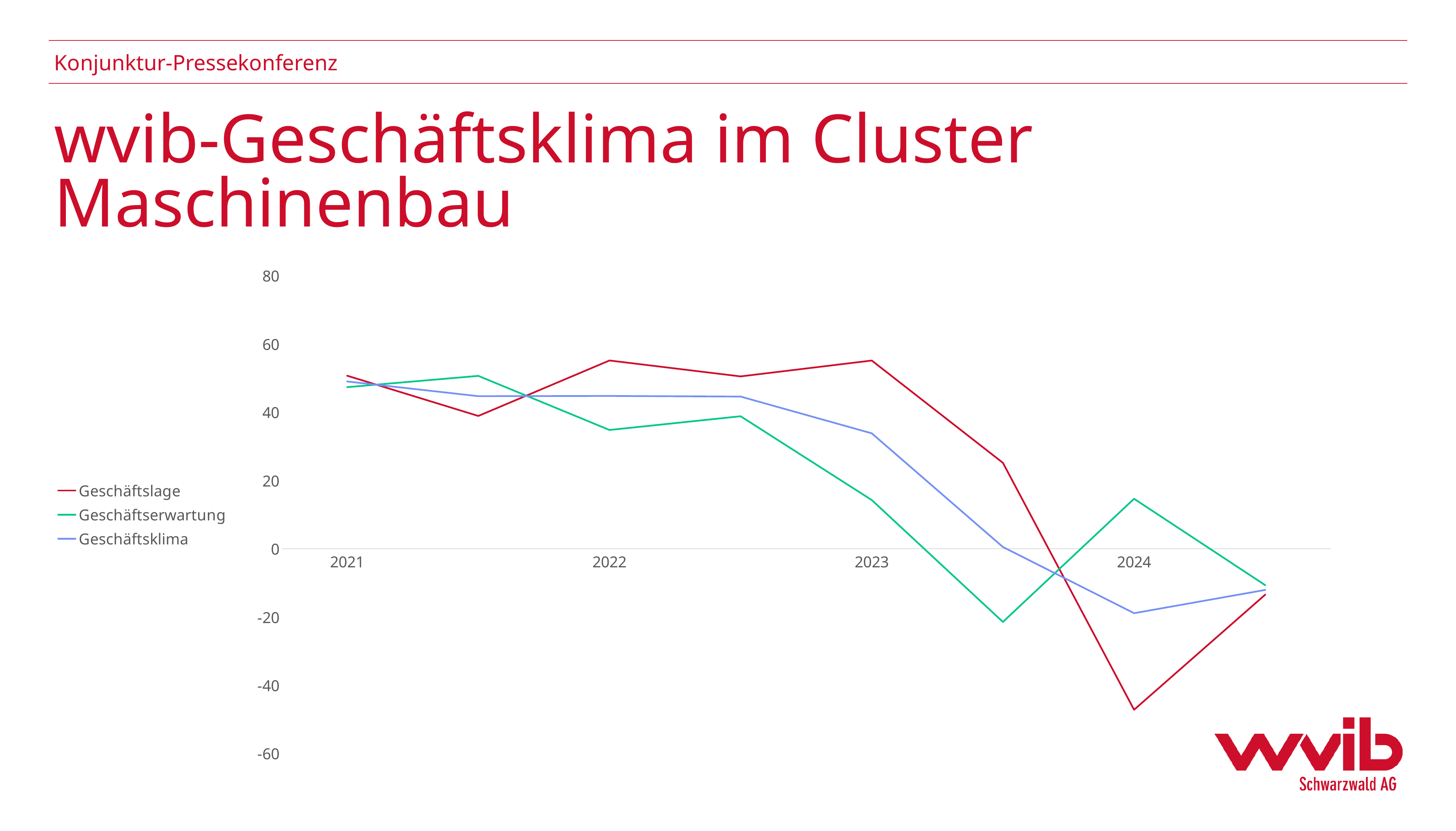
Which series is shown in green in the legend? Geschäftserwartung What kind of chart is shown on the slide? line chart Does the Geschäftslage line rise or fall from 2023 to 2024? fall How many years are labelled on the x axis? 4 Is the value for Geschäftsklima at 2023 greater or less than 20? greater Is the value for Geschäftslage at 2023 greater or less than 40? greater Which series has the highest value at 2024? Geschäftserwartung Which series is shown in red in the legend? Geschäftslage Is the value for Geschäftserwartung at 2024 greater or less than 0? greater How many series does the legend list? 3 Which series has the lowest value at 2024? Geschäftslage